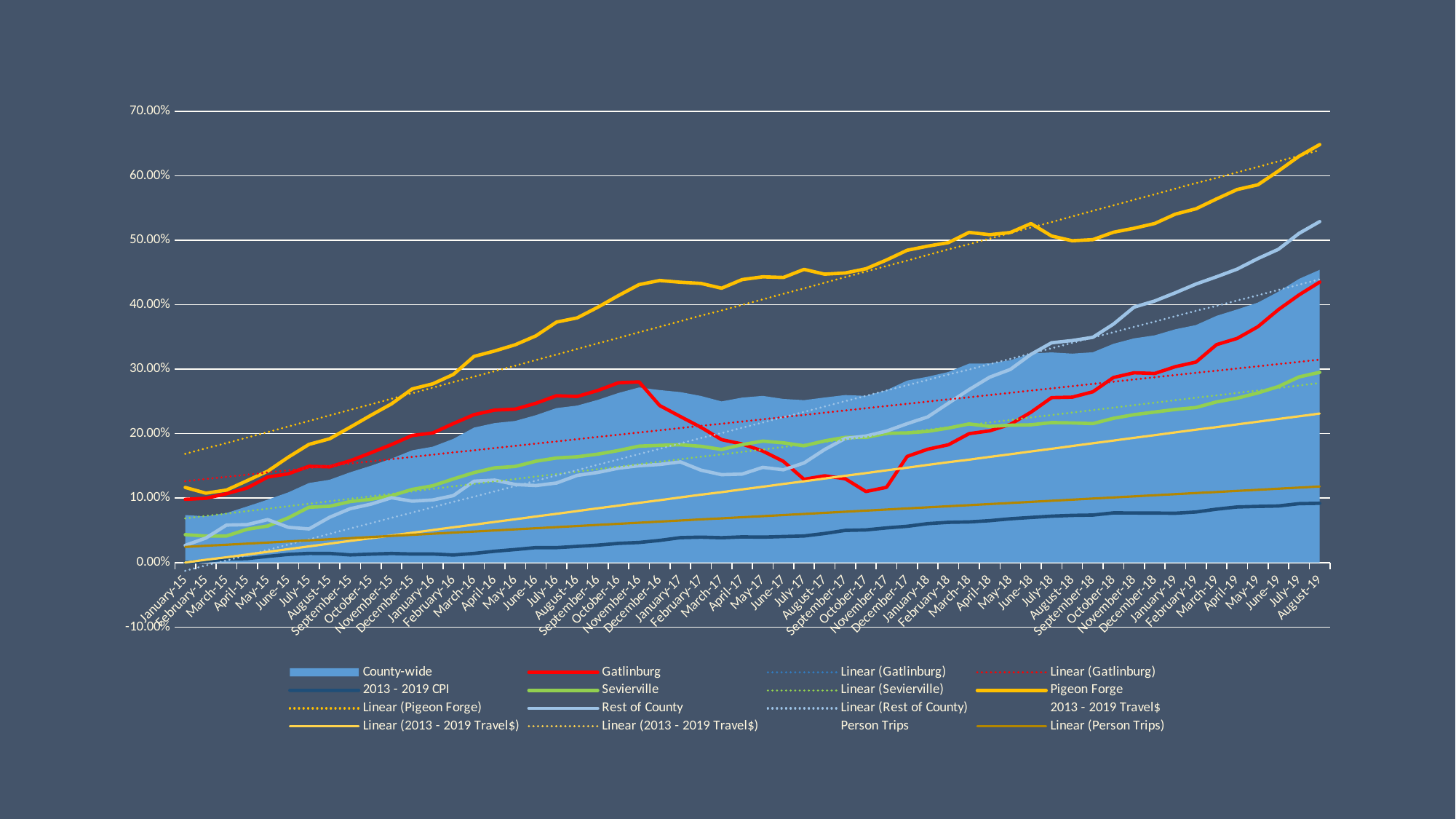
Does the Pigeon Forge line generally rise or fall from January-15 to August-19? rise What kind of chart is shown on the slide? combination area and line chart Which series has the lowest value in August-19? 2013 - 2019 CPI Is the value for Pigeon Forge in August-19 greater or less than 60.00%? greater How many monthly points are plotted along the x axis, from January-15 to August-19? 56 Is the value for 2013 - 2019 CPI in August-19 greater or less than 10.00%? less How many entries does the legend list? 16 In August-19, which is larger: Pigeon Forge or Gatlinburg? Pigeon Forge Is the value for Gatlinburg in November-17 greater or less than 20.00%? less Which series has the highest value in August-19? Pigeon Forge